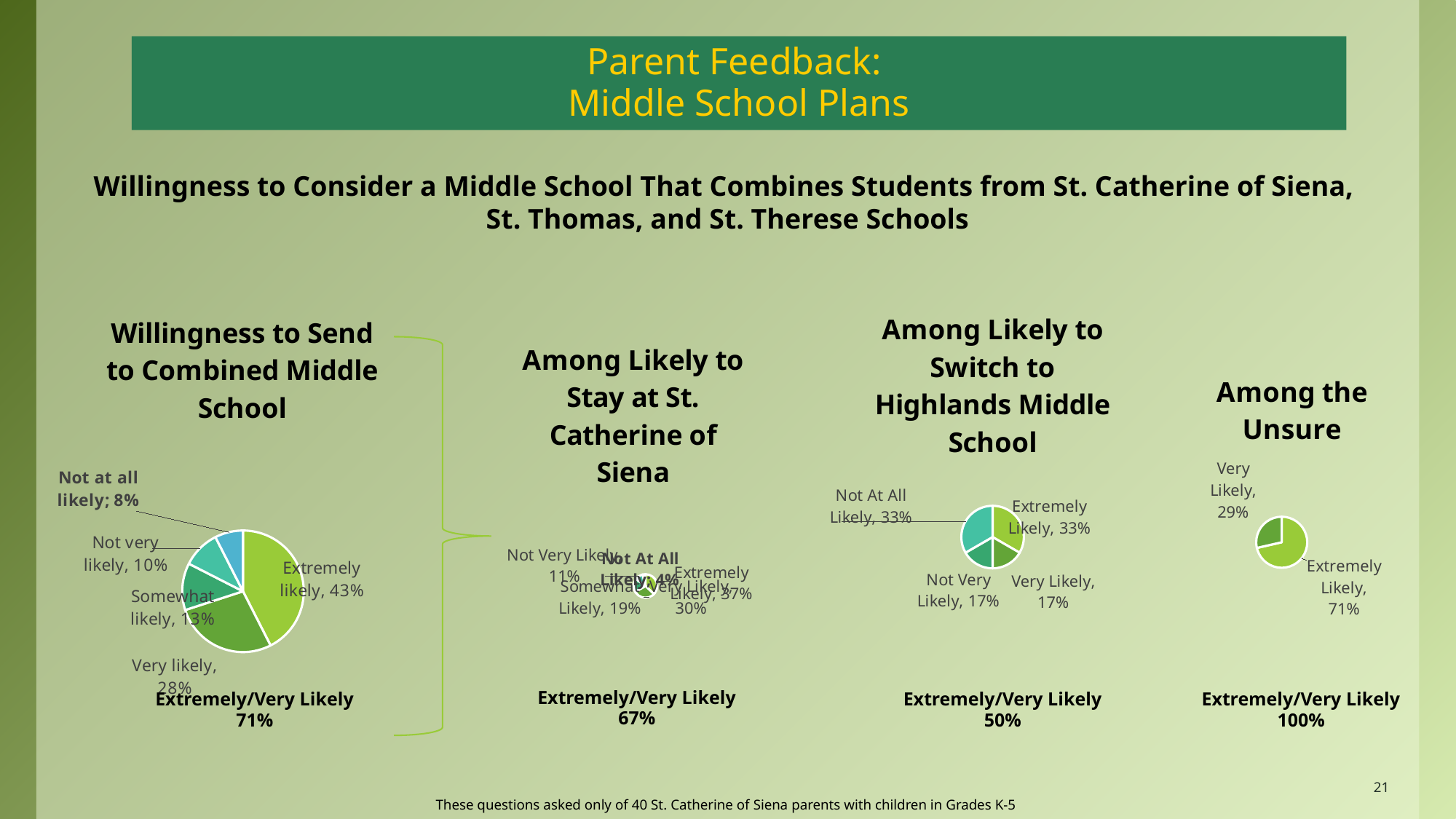
What is the Extremely/Very Likely percentage shown under the 'Among Likely to Stay at St. Catherine of Siena' chart? 67% In the 'Among Likely to Switch to Highlands Middle School' pie chart, which is larger: Extremely Likely or Very Likely? Extremely Likely In the 'Willingness to Send to Combined Middle School' pie chart, how many categories are shown? 5 In the 'Willingness to Send to Combined Middle School' pie chart, what is the difference between the Extremely likely and Very likely shares? 15% In the 'Willingness to Send to Combined Middle School' pie chart, what share of parents are extremely likely? 43% In the 'Among the Unsure' pie chart, what share is Extremely Likely? 71% What kind of chart is used for 'Among the Unsure'? Pie chart In the 'Among Likely to Switch to Highlands Middle School' pie chart, what share is Not At All Likely? 33% In the 'Among the Unsure' pie chart, what share is Very Likely? 29% In the 'Willingness to Send to Combined Middle School' pie chart, which category has the smallest slice? Not at all likely In the 'Willingness to Send to Combined Middle School' pie chart, which category has the largest slice? Extremely likely In the 'Willingness to Send to Combined Middle School' pie chart, what share of parents are not at all likely? 8%